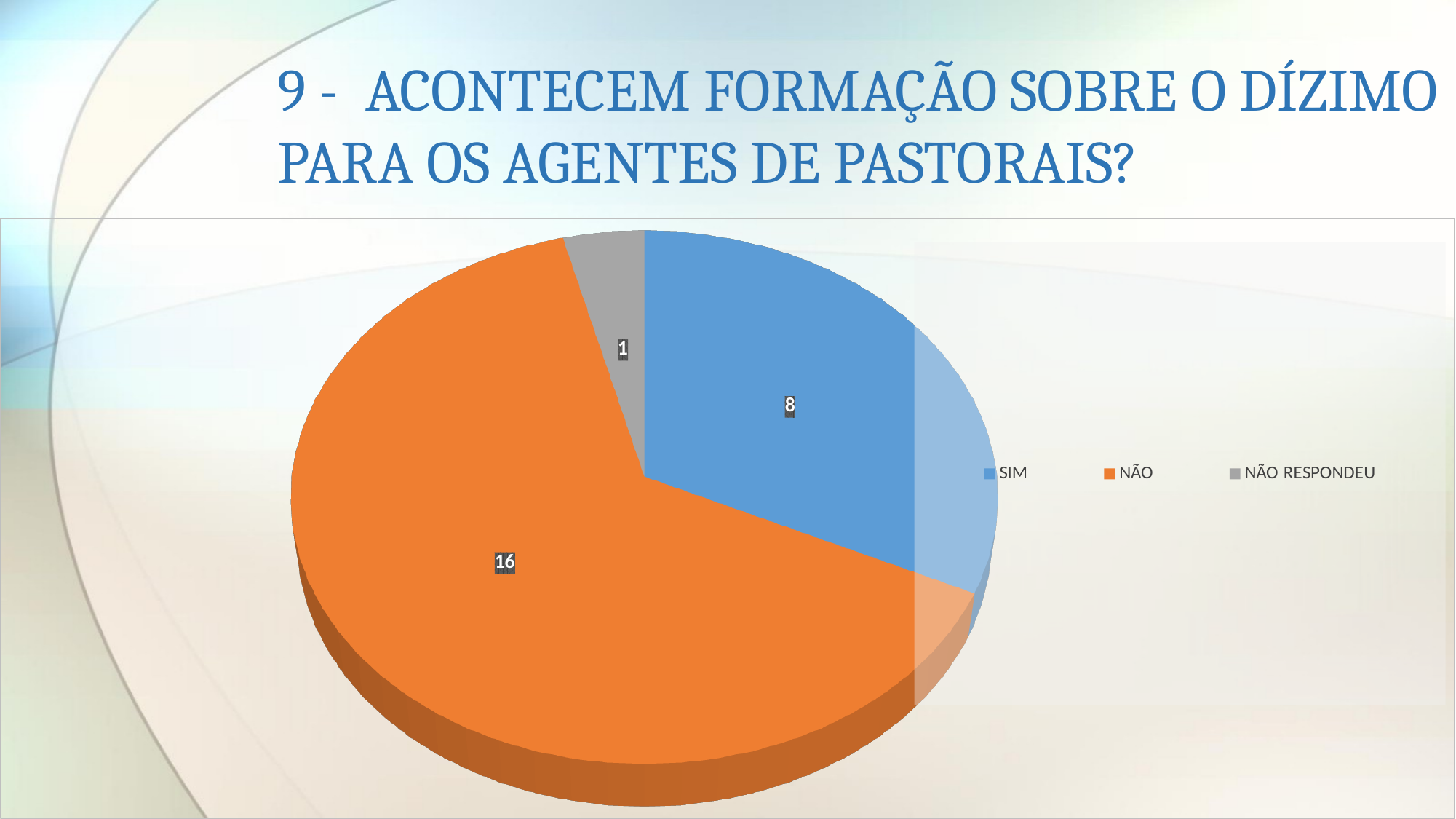
What is the difference between the values for NÃO and SIM? 8 What is the value for NÃO RESPONDEU? 1 What colour is the slice for NÃO RESPONDEU? grey How many categories does the pie chart have? 3 What is the value for SIM? 8 What is the value for NÃO? 16 What is the total of all slices in the pie chart? 25 What kind of chart is shown on the slide? pie chart What share of the pie does NÃO represent? 64% Which category has the smallest slice? NÃO RESPONDEU Which category has the largest slice? NÃO Which is larger, the value for SIM or the value for NÃO RESPONDEU? SIM